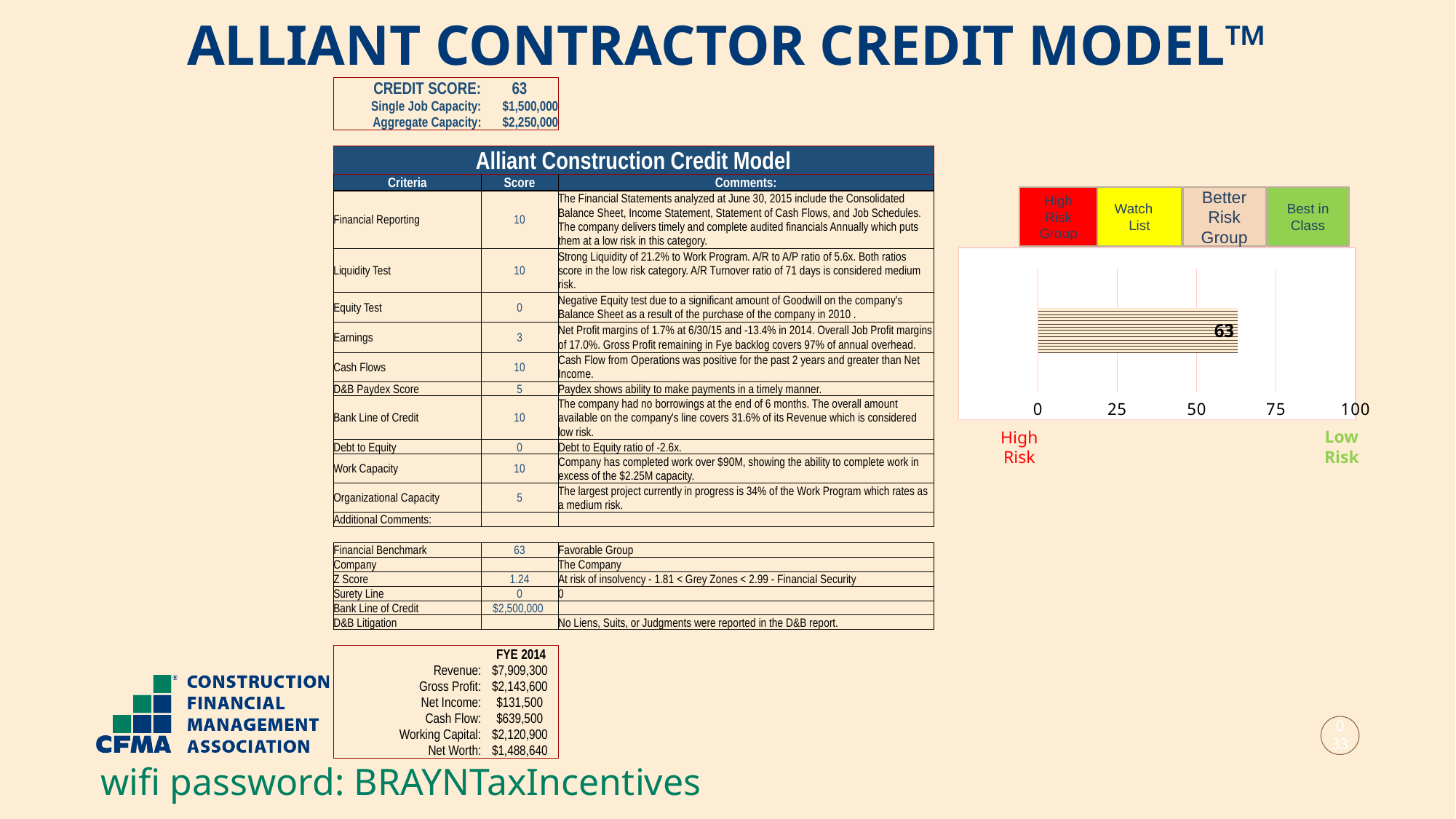
How many bars are plotted in the chart? 1 What label appears at the left end of the chart's axis, below 0? High Risk What value is labelled on the bar in the chart? 63 Is the value of the bar in the chart greater or less than 75? less Is the bar in the chart drawn horizontally or vertically? horizontally Is the value of the bar in the chart greater or less than 50? greater What kind of chart is shown on the right side of the slide? bar chart What is the highest value shown on the chart's horizontal axis? 100